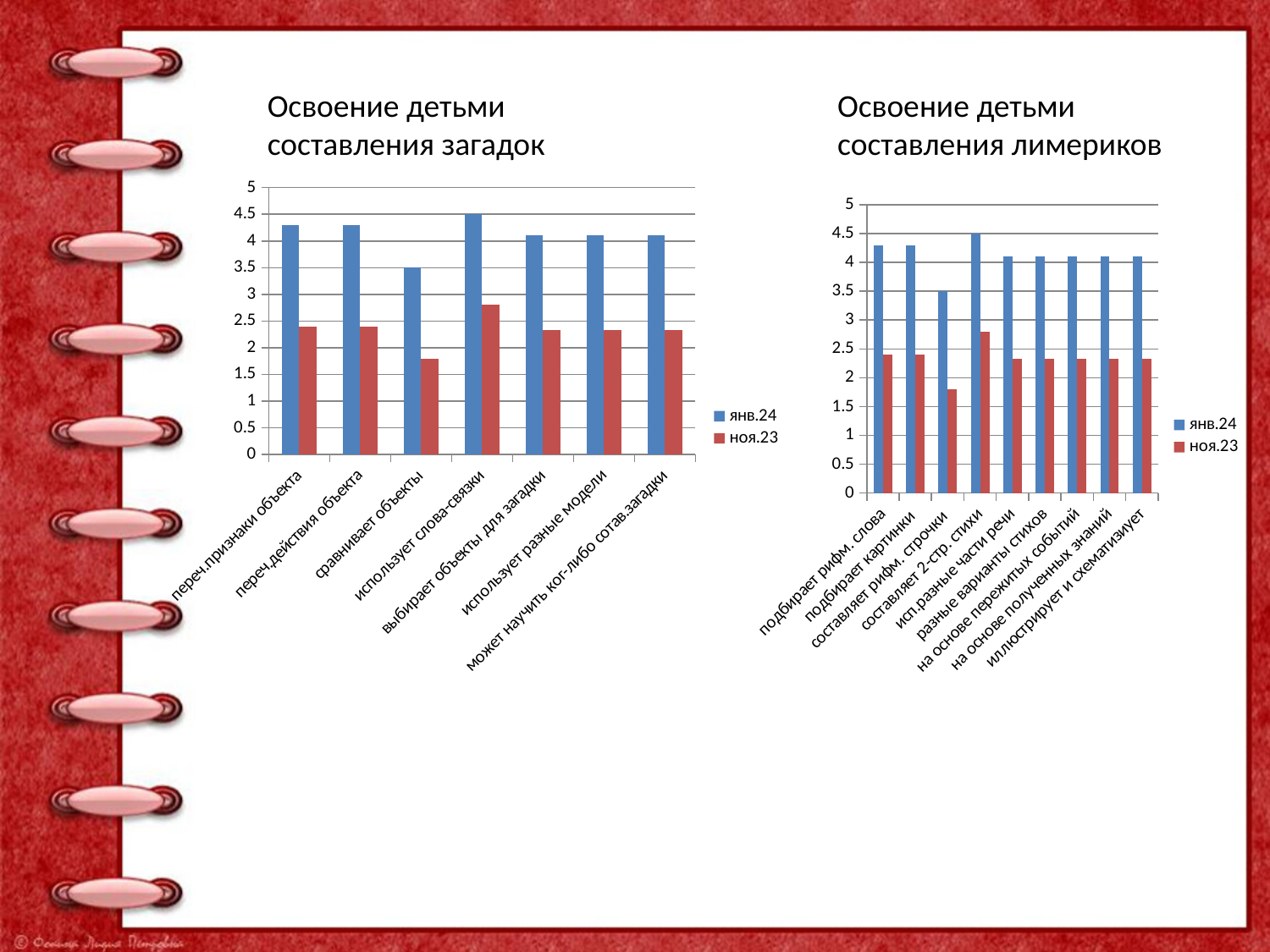
How many categories are shown on the x axis of the chart 'Освоение детьми составления загадок'? 7 In the chart 'Освоение детьми составления загадок', is the ноя.23 value for 'сравнивает объекты' greater or less than 2? less In the chart 'Освоение детьми составления загадок', which category has the lowest value for the series янв.24? сравнивает объекты In the chart 'Освоение детьми составления загадок', which category has the highest value for the series ноя.23? использует слова-связки In the chart 'Освоение детьми составления загадок', which series has the larger value for 'использует слова-связки', янв.24 or ноя.23? янв.24 How many series does the legend of the chart 'Освоение детьми составления лимериков' list? 2 How many categories are shown on the x axis of the chart 'Освоение детьми составления лимериков'? 9 In the chart 'Освоение детьми составления загадок', is the янв.24 value for 'сравнивает объекты' greater or less than 4? less What type of chart is the chart titled 'Освоение детьми составления загадок'? bar chart In the chart 'Освоение детьми составления лимериков', which category has the highest value for the series ноя.23? составляет 2-стр. стихи In the chart 'Освоение детьми составления лимериков', is the янв.24 value for 'подбирает рифм. слова' greater or less than 4? greater In the chart 'Освоение детьми составления лимериков', which category has the lowest value for the series янв.24? составляет рифм. строчки